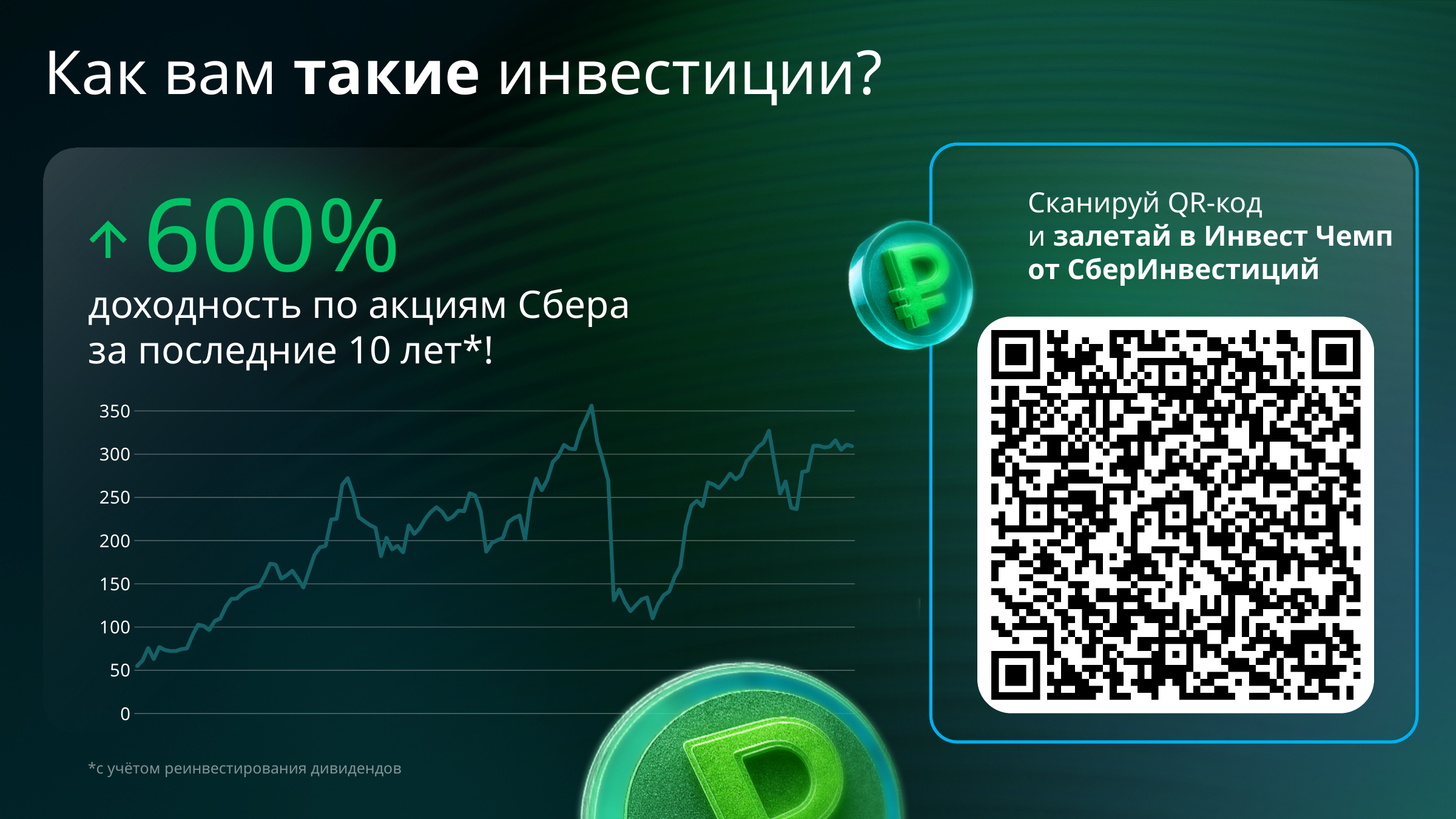
Is the highest peak of the line greater or less than 300? greater Is the value at the right end of the line greater or less than 300? greater Overall, does the line in the chart rise or fall from left to right? rise Is the lowest point of the line in the right half of the chart greater or less than 150? less What is the highest value labelled on the chart's vertical axis? 350 How many lines are plotted in the chart? 1 What kind of chart is shown on the slide? line chart What is the interval between consecutive tick labels on the chart's vertical axis? 50